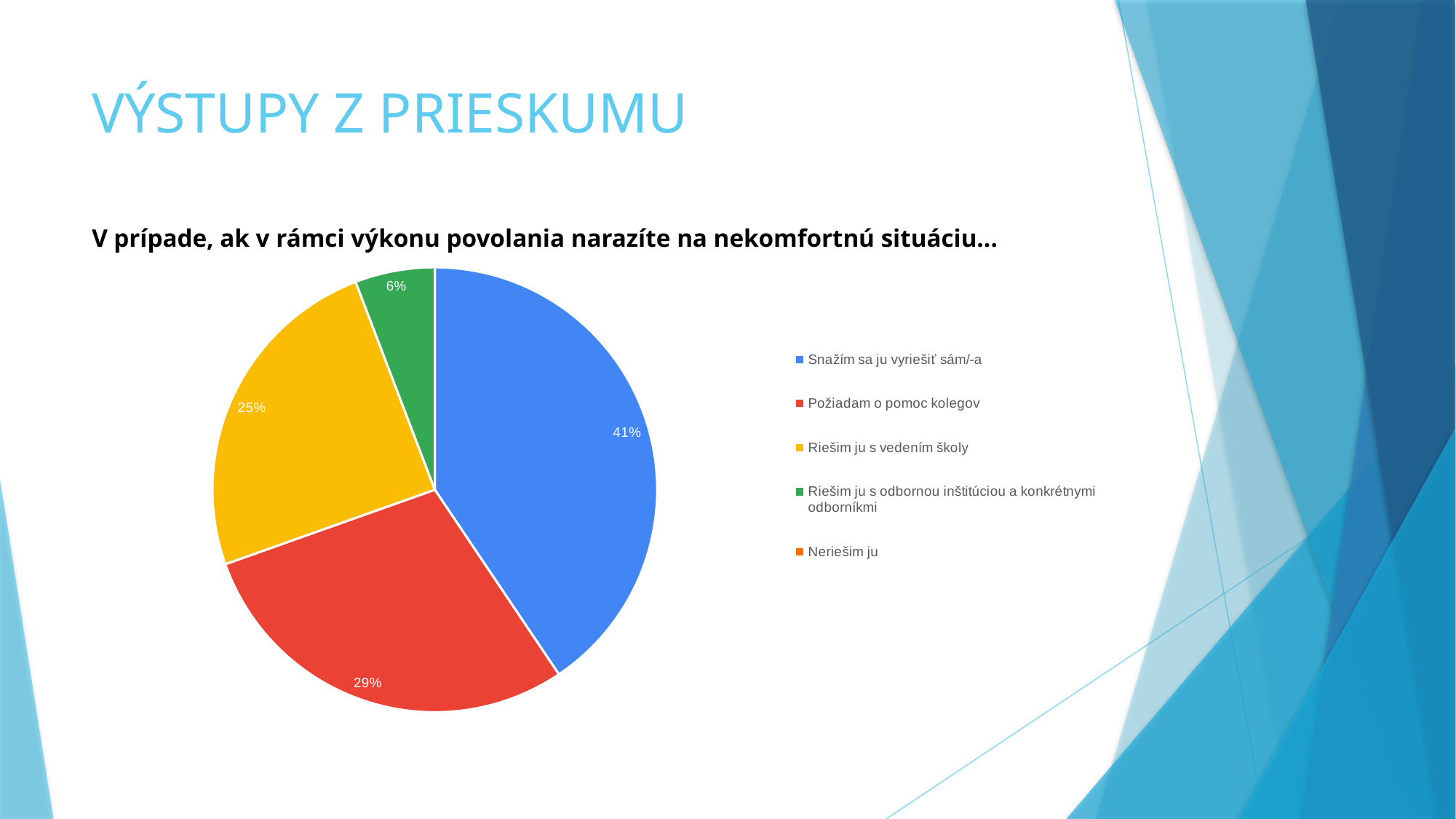
Which labelled slice of the pie is the smallest? Riešim ju s odbornou inštitúciou a konkrétnymi odborníkmi What is the difference in percentage points between "Snažím sa ju vyriešiť sám/-a" and "Požiadam o pomoc kolegov"? 12 What share of the pie does "Riešim ju s vedením školy" have? 25% What share of the pie does "Riešim ju s odbornou inštitúciou a konkrétnymi odborníkmi" have? 6% What share of the pie does "Požiadam o pomoc kolegov" have? 29% Which category has the largest slice of the pie? Snažím sa ju vyriešiť sám/-a What is the title of the pie chart? V prípade, ak v rámci výkonu povolania narazíte na nekomfortnú situáciu… Which is larger: the slice for "Požiadam o pomoc kolegov" or the slice for "Riešim ju s vedením školy"? Požiadam o pomoc kolegov What kind of chart is shown on the slide? pie chart How many entries does the legend of the pie chart list? 5 What colour is the slice for "Riešim ju s vedením školy"? yellow What share of the pie does "Snažím sa ju vyriešiť sám/-a" have? 41%